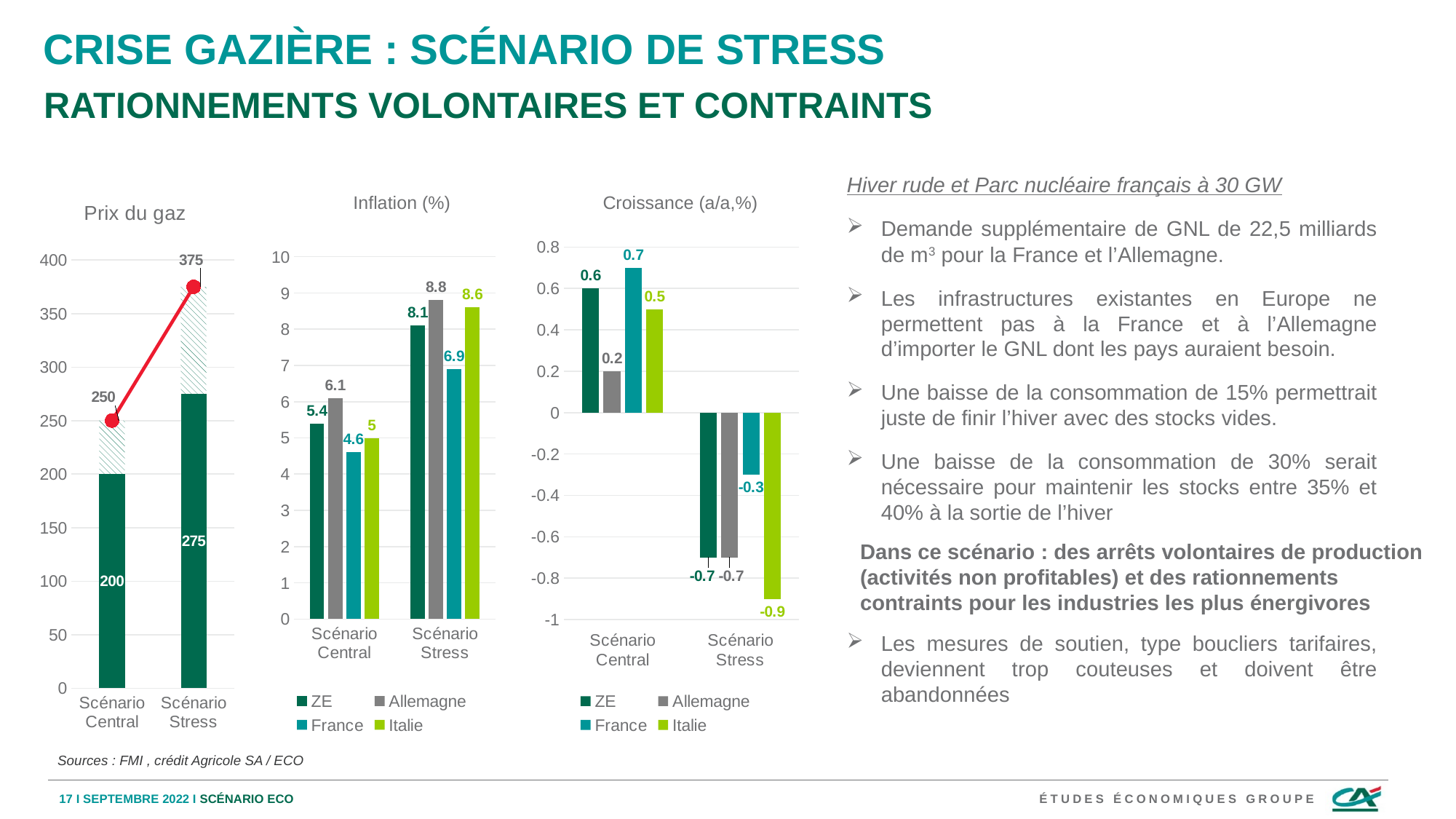
In the 'Prix du gaz' chart, what is the value of the line point for Scénario Central? 250 In the 'Inflation (%)' chart, which country has the lowest value under Scénario Central? France In the 'Prix du gaz' chart, do the bar values rise or fall from Scénario Central to Scénario Stress? rise In the 'Croissance (a/a,%)' chart, what is the value for France under Scénario Central? 0.7 In the 'Croissance (a/a,%)' chart, is the value for Allemagne under Scénario Central larger or smaller than the value for Italie under Scénario Central? smaller In the 'Inflation (%)' chart, what is the value for Allemagne under Scénario Stress? 8.8 In the 'Croissance (a/a,%)' chart, which country has the lowest value under Scénario Stress? Italie In the 'Prix du gaz' chart, what is the difference between the two bar values (Scénario Stress minus Scénario Central)? 75 In the 'Inflation (%)' chart, what is the difference between the ZE values for Scénario Stress and Scénario Central? 2.7 In the 'Prix du gaz' chart, what is the bar value for Scénario Stress? 275 How many series does the legend of the 'Inflation (%)' chart list? 4 What kind of chart is the 'Croissance (a/a,%)' chart? bar chart